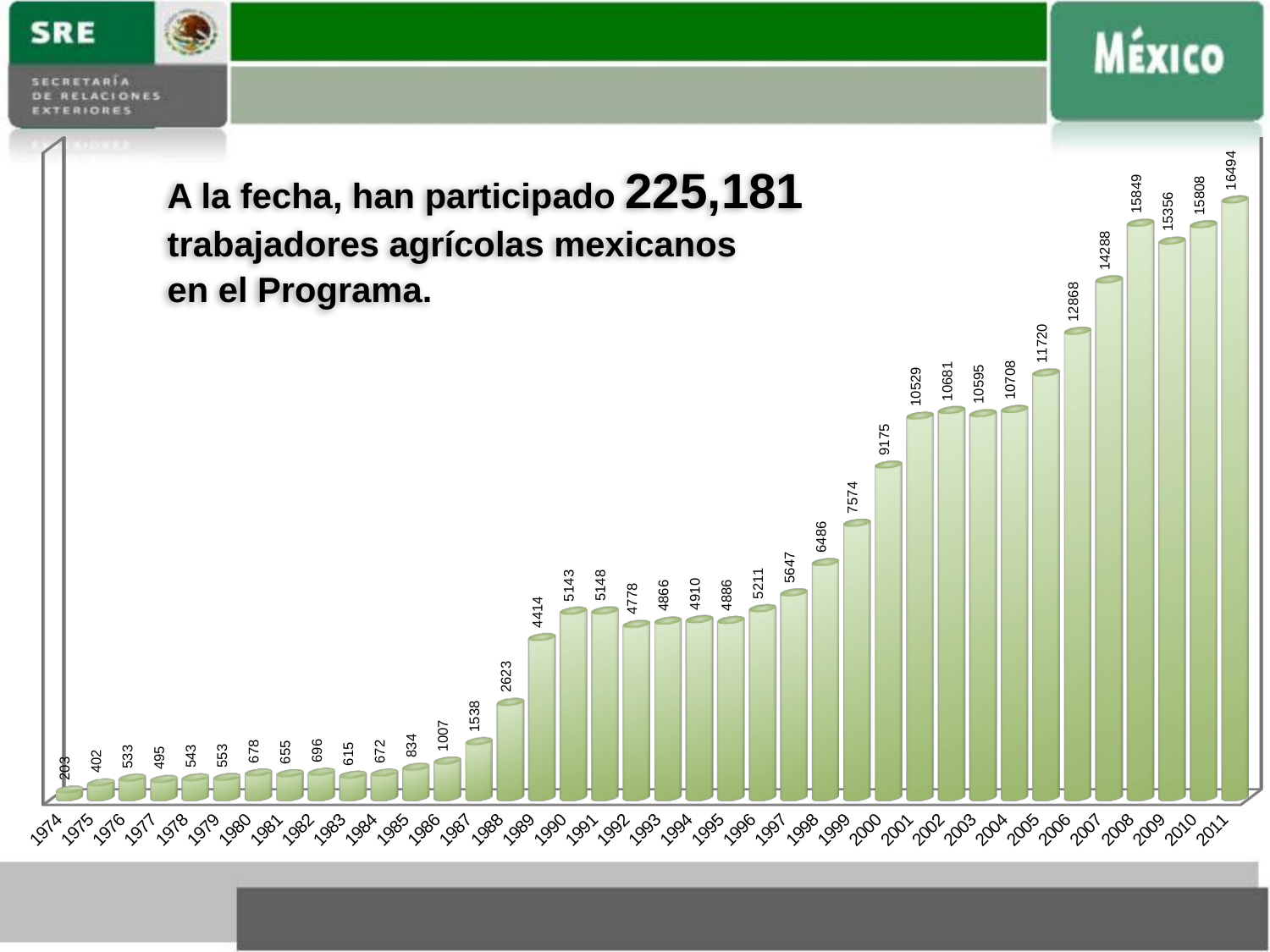
Which year has the highest value? 2011 Which is larger, the value for 2005 or the value for 2006? 2006 What is the difference between the values for 2011 and 2010? 686 Which year has the lowest value? 1974 How many years are shown on the x axis? 38 What is the value shown for 1988? 2623 What is the value shown for 2000? 9175 Do the values generally rise or fall from 1974 to 2011? rise What is the value shown for 2011? 16494 What kind of chart is shown on the slide? bar chart Which is larger, the value for 1990 or the value for 1992? 1990 What is the difference between the values for 2008 and 2009? 493